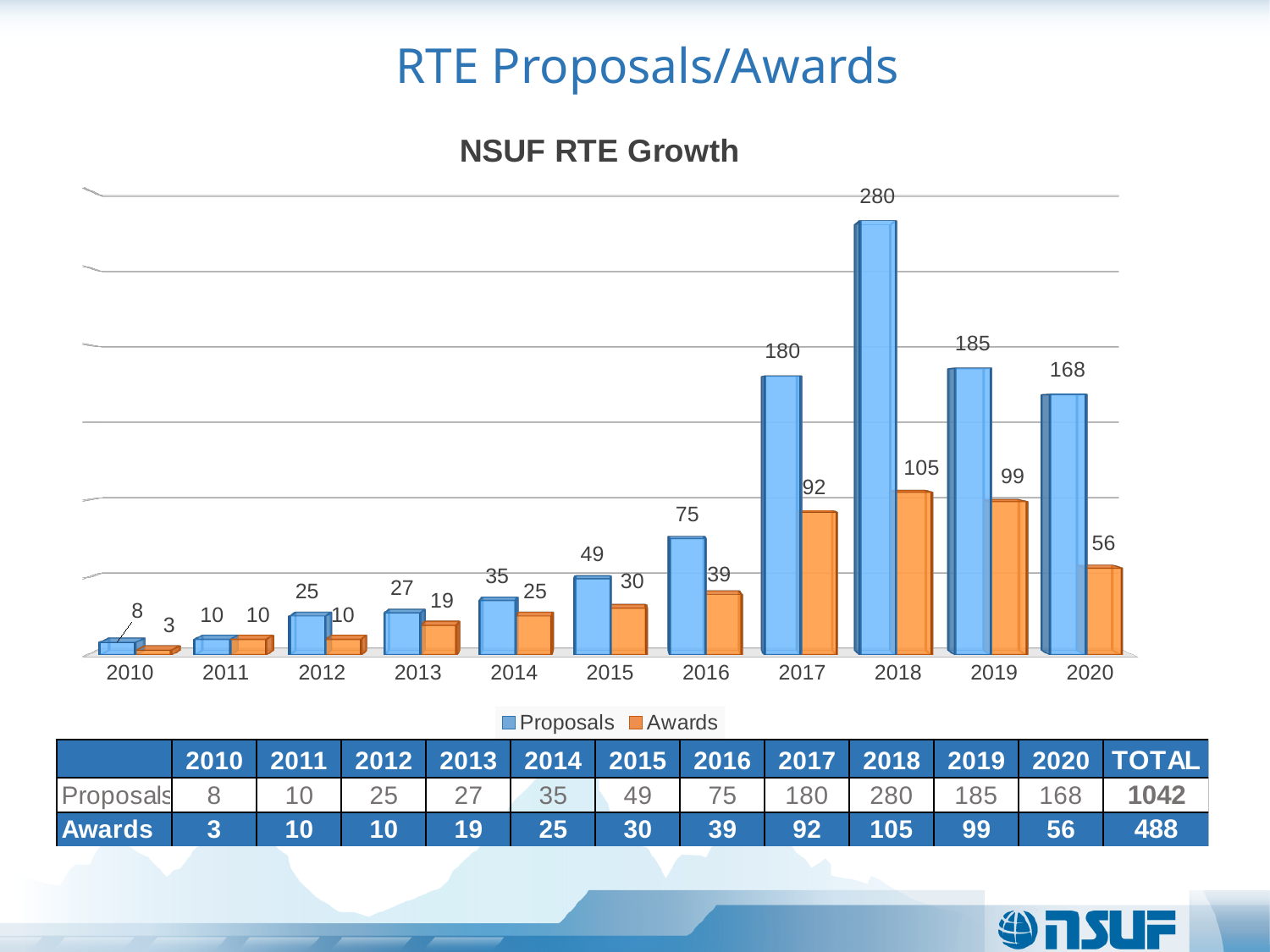
What is the value for Proposals in 2018? 280 What is the title of the chart? NSUF RTE Growth What is the value for Awards in 2017? 92 How many series does the legend list? 2 Do Proposals rise or fall from 2010 to 2018? rise Which year has the highest number of Proposals? 2018 Which year has the lowest number of Awards? 2010 How many years are shown on the x axis? 11 What colour are the Awards bars? orange Which is larger, Proposals in 2019 or Proposals in 2020? Proposals in 2019 What is the difference between Proposals and Awards in 2018? 175 What kind of chart is shown? bar chart